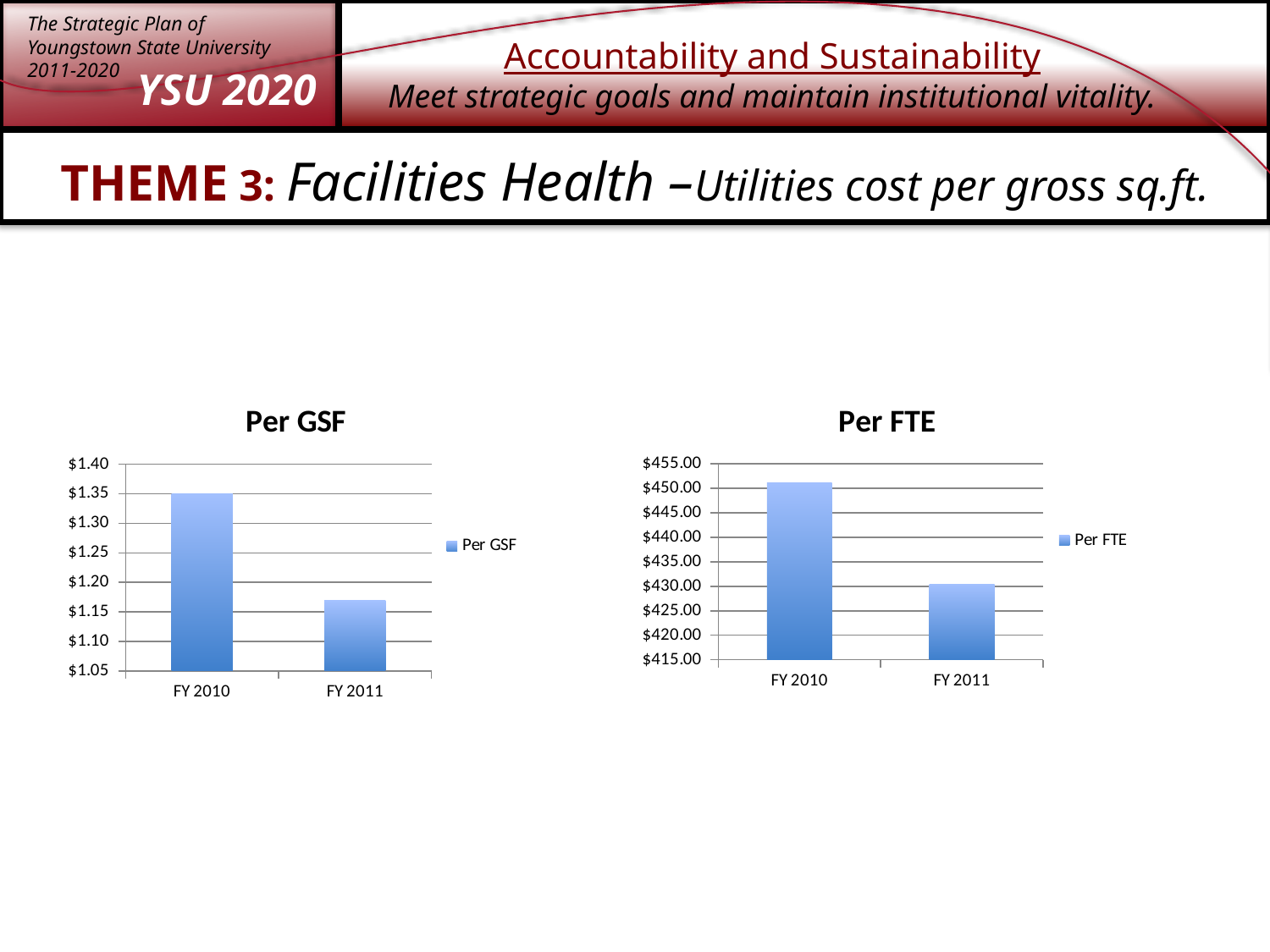
In the Per GSF chart, what is the value for FY 2010? $1.35 In the Per GSF chart, what kind of chart is shown? bar chart In the Per GSF chart, do the values rise or fall from FY 2010 to FY 2011? fall In the Per GSF chart, is the value for FY 2011 greater or less than $1.20? less In the Per FTE chart, is the value for FY 2011 greater or less than $435.00? less In the Per FTE chart, is the value for FY 2010 greater or less than $450.00? greater In the Per FTE chart, which fiscal year has the lower value? FY 2011 In the Per GSF chart, which fiscal year has the higher value? FY 2010 In the Per GSF chart, how many categories are plotted on the x axis? 2 In the Per GSF chart, how many series does the legend list? 1 How many charts are shown on the slide? 2 In the Per FTE chart, what kind of chart is shown? bar chart